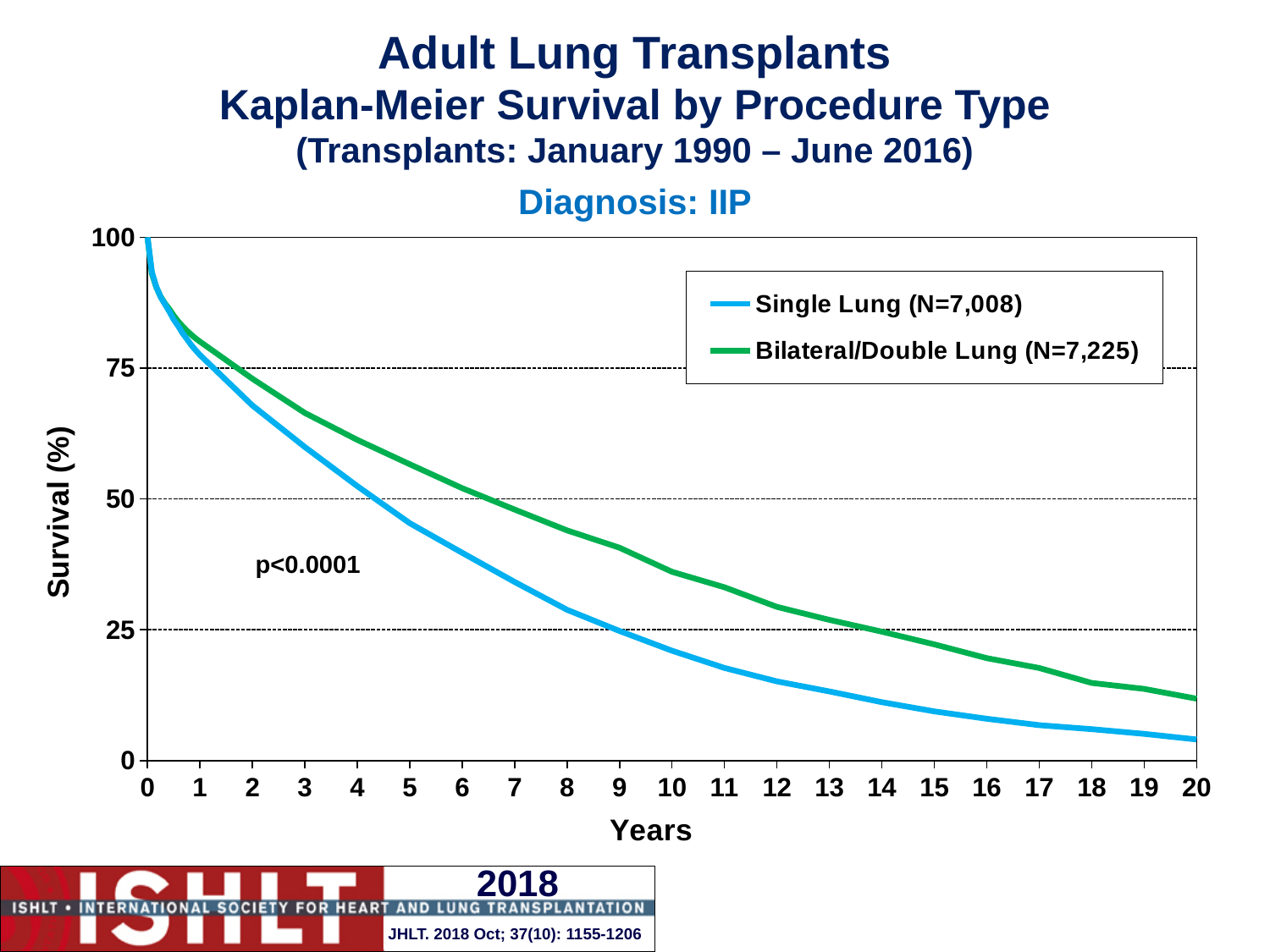
What kind of chart is shown on the slide? line chart At 10 years, which procedure type has the higher survival, Single Lung or Bilateral/Double Lung? Bilateral/Double Lung Is the survival value for Bilateral/Double Lung at 20 years greater or less than 25? less Is the survival value for Bilateral/Double Lung at 10 years greater or less than 25? greater Is the survival value for Single Lung at 5 years greater or less than 50? less Do the survival curves rise or fall as years increase? fall How many series does the legend list? 2 What p-value is printed on the chart? p<0.0001 What N is shown in the legend for Bilateral/Double Lung? 7,225